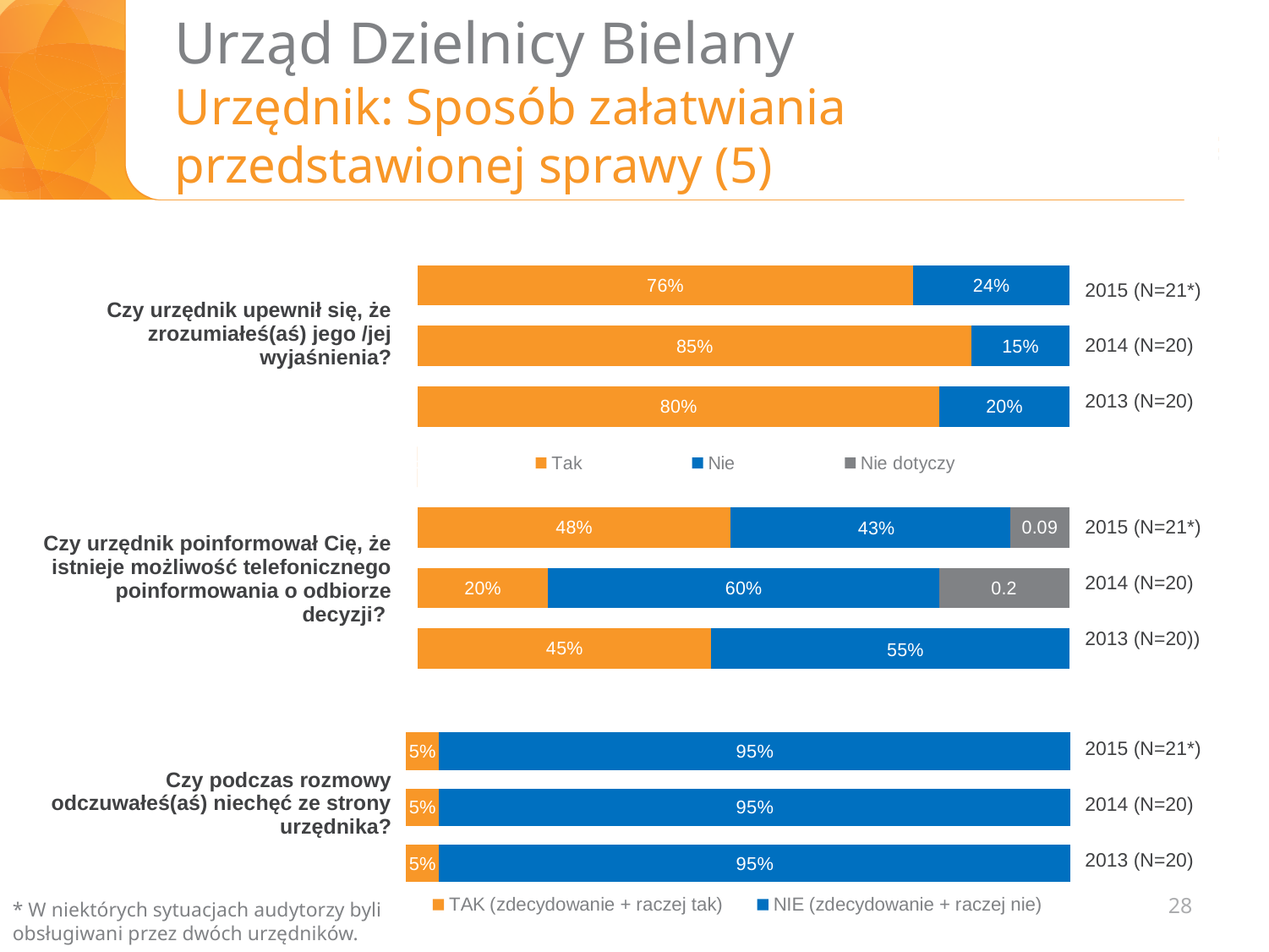
In the chart for "Czy urzędnik upewnił się, że zrozumiałeś(aś) jego /jej wyjaśnienia?", which year has the highest Tak value? 2014 (N=20) In the chart for "Czy urzędnik upewnił się, że zrozumiałeś(aś) jego /jej wyjaśnienia?", what is the difference between the Tak values for 2014 (N=20) and 2015 (N=21*)? 9% In the chart for "Czy podczas rozmowy odczuwałeś(aś) niechęć ze strony urzędnika?", what is the NIE (zdecydowanie + raczej nie) value for 2013 (N=20)? 95% How many series does the legend of the chart for "Czy urzędnik upewnił się, że zrozumiałeś(aś) jego /jej wyjaśnienia?" list? 3 In the chart for "Czy urzędnik poinformował Cię, że istnieje możliwość telefonicznego poinformowania o odbiorze decyzji?", which year has the lowest Tak value? 2014 (N=20) In the chart for "Czy urzędnik poinformował Cię, że istnieje możliwość telefonicznego poinformowania o odbiorze decyzji?", what is the Nie value for 2014 (N=20)? 60% In the chart for "Czy urzędnik upewnił się, że zrozumiałeś(aś) jego /jej wyjaśnienia?", what is the Nie value for 2015 (N=21*)? 24% What type of chart is used for "Czy podczas rozmowy odczuwałeś(aś) niechęć ze strony urzędnika?"? Stacked bar chart How many year bars are shown in the chart for "Czy podczas rozmowy odczuwałeś(aś) niechęć ze strony urzędnika?"? 3 In the chart for "Czy urzędnik upewnił się, że zrozumiałeś(aś) jego /jej wyjaśnienia?", what is the Tak value for 2014 (N=20)? 85% In the chart for "Czy urzędnik poinformował Cię, że istnieje możliwość telefonicznego poinformowania o odbiorze decyzji?", which is larger for 2013 (N=20)): Tak or Nie? Nie In the chart for "Czy urzędnik poinformował Cię, że istnieje możliwość telefonicznego poinformowania o odbiorze decyzji?", what is the Nie dotyczy value for 2015 (N=21*)? 0.09